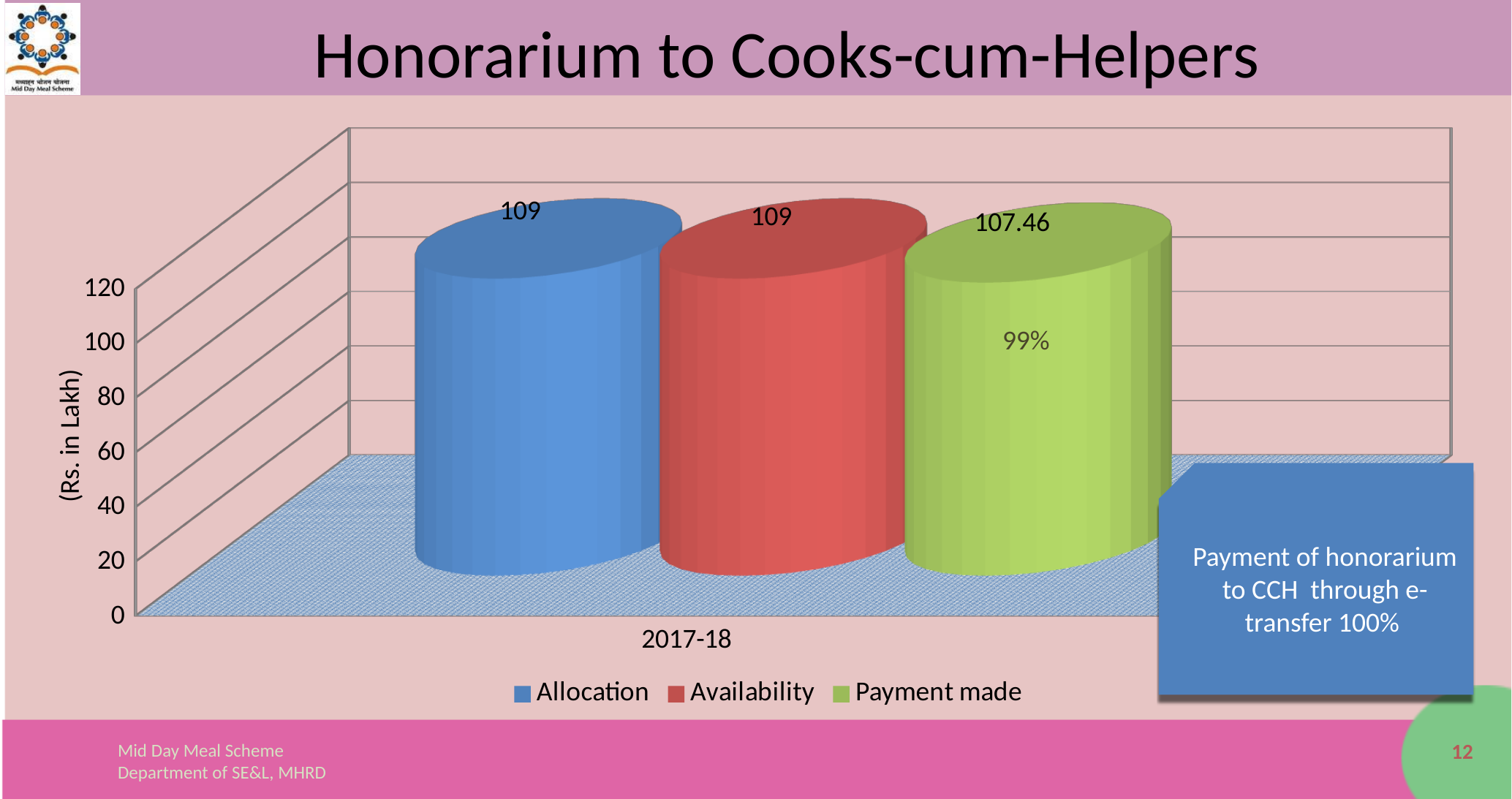
What kind of chart is shown on the slide? Bar chart What is the label of the vertical axis? (Rs. in Lakh) Which series has the lowest value in 2017-18? Payment made Which is larger, Allocation or Payment made? Allocation Is the value for Payment made greater or less than 100? greater How many series does the legend list? 3 How many categories are shown on the x axis? 1 What percentage label is shown on the Payment made bar? 99% What is the value for Allocation in 2017-18? 109 What is the value for Availability in 2017-18? 109 What is the difference between Availability and Payment made in 2017-18? 1.54 What is the value for Payment made in 2017-18? 107.46